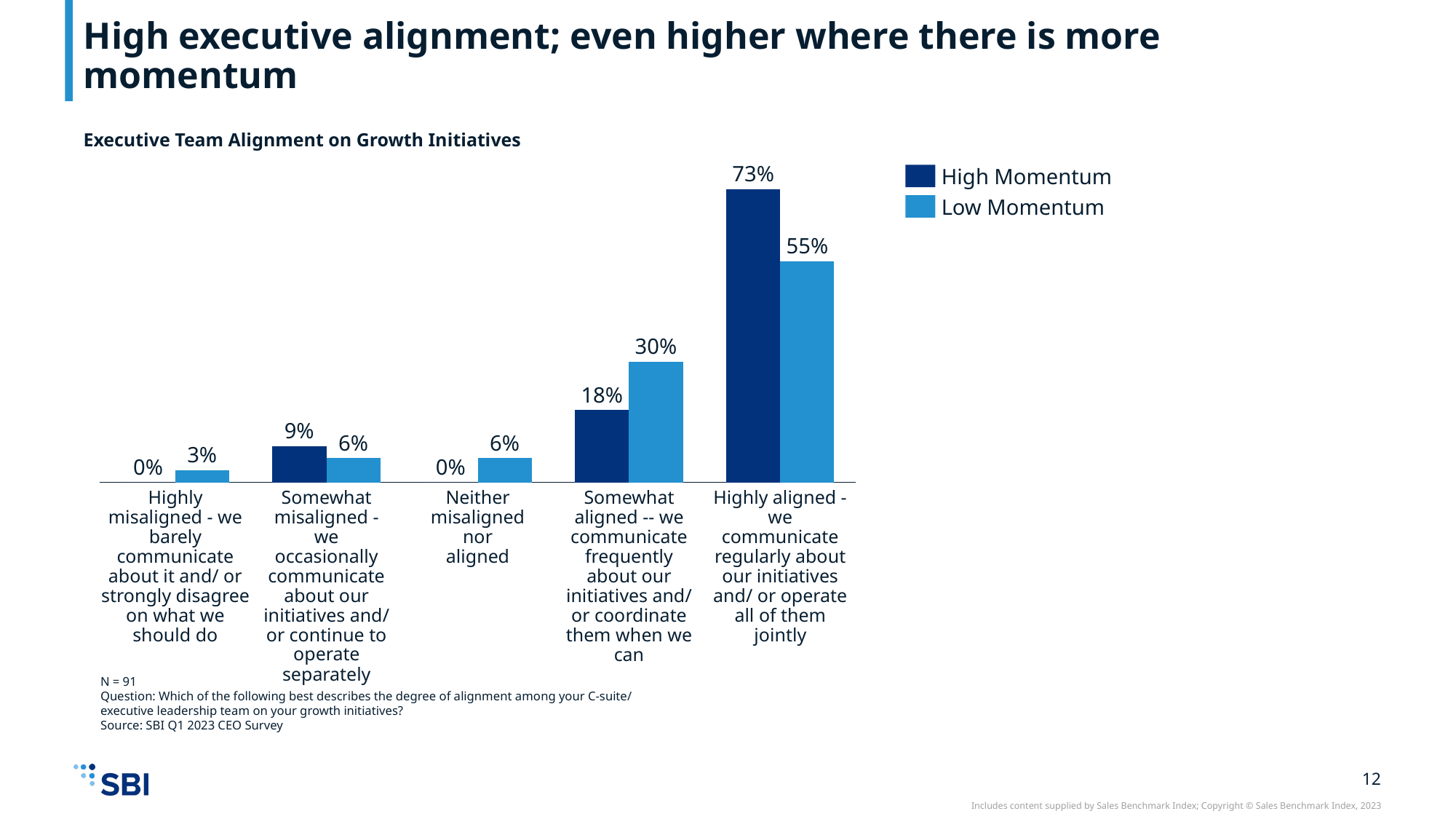
How many categories are shown on the x axis? 5 Which category has the lowest Low Momentum value? Highly misaligned What is the title of the chart? Executive Team Alignment on Growth Initiatives What kind of chart is shown on the slide? Bar chart What is the High Momentum value for "Somewhat misaligned"? 9% What is the Low Momentum value for "Neither misaligned nor aligned"? 6% What is the Low Momentum value for "Somewhat aligned"? 30% What is the High Momentum value for "Highly aligned"? 73% For "Somewhat aligned", which is larger: High Momentum or Low Momentum? Low Momentum What is the difference between the High Momentum and Low Momentum values for "Highly aligned"? 18% How many series does the legend list? 2 Which category has the highest Low Momentum value? Highly aligned